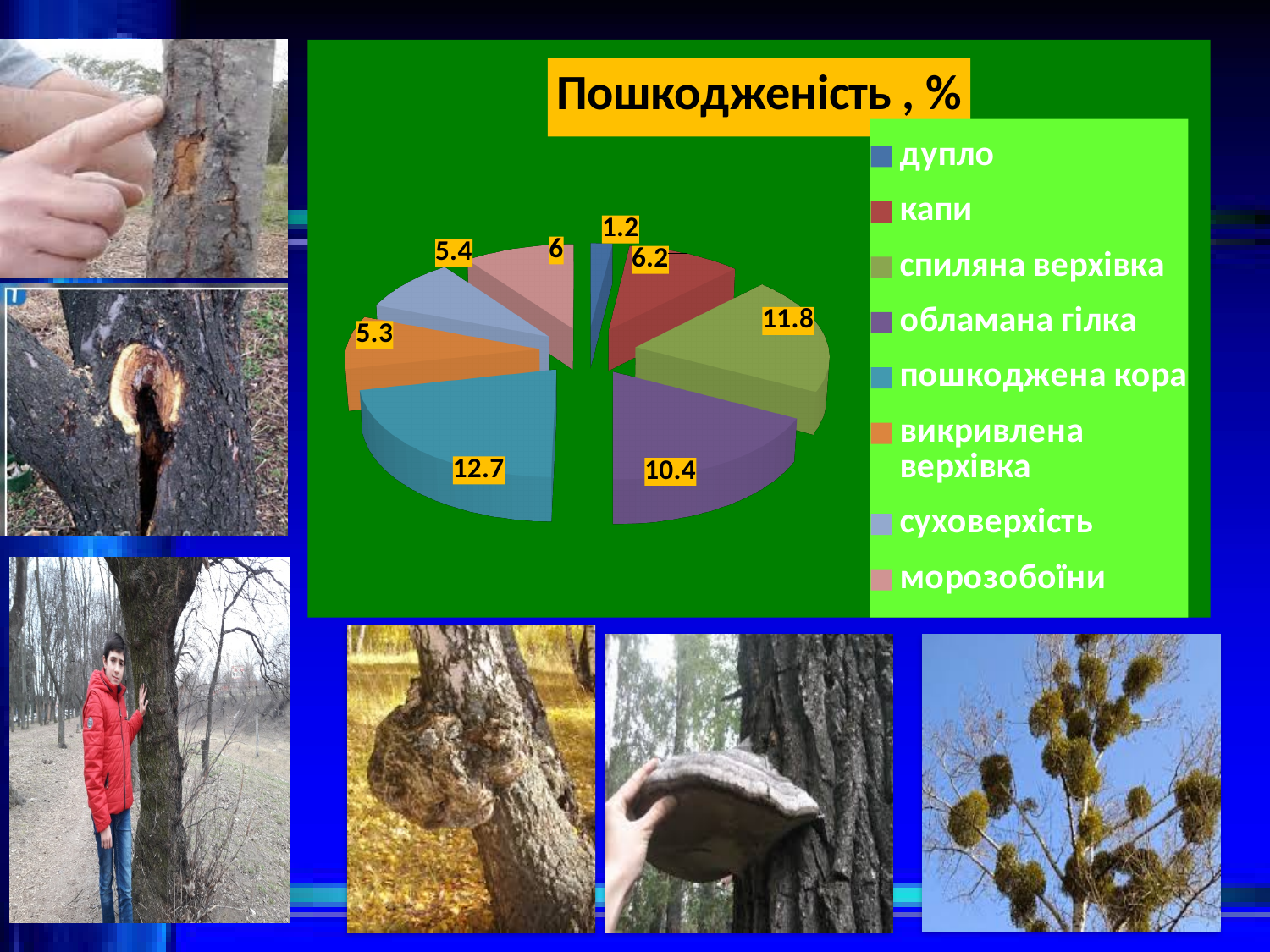
What is the difference between the values for пошкоджена кора and обламана гілка? 2.3 What colour is the slice for викривлена верхівка? orange What is the value for спиляна верхівка? 11.8 Which is larger, the value for капи or the value for обламана гілка? обламана гілка How many categories does the pie chart have? 8 Which category has the largest value? пошкоджена кора What is the value for дупло? 1.2 What is the title of the chart? Пошкодженість , % What is the value for морозобоїни? 6 What type of chart is shown on the slide? pie chart Which category has the smallest value? дупло What is the value for пошкоджена кора? 12.7